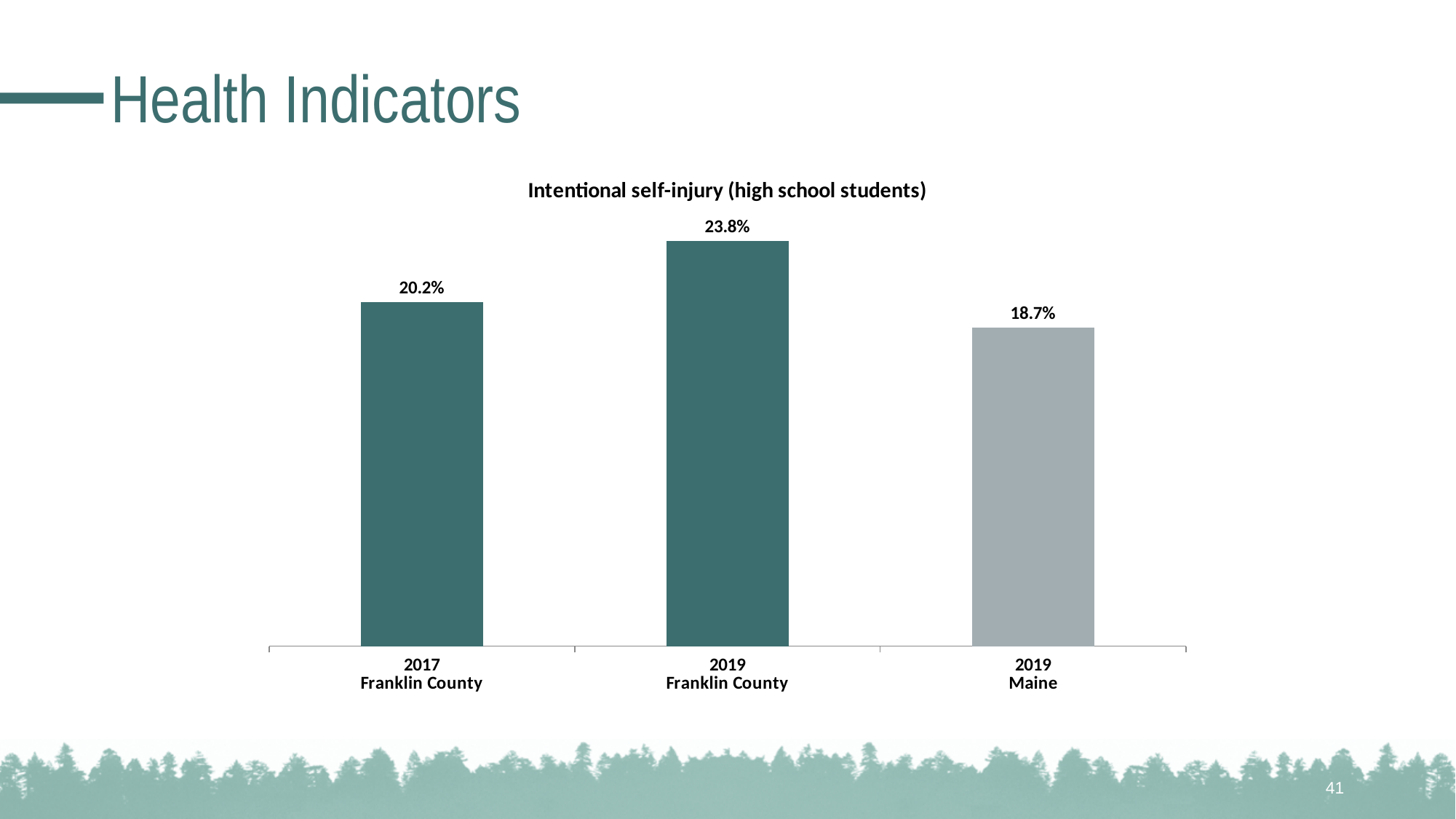
Did the Franklin County value rise or fall from 2017 to 2019? Rise What is the difference between the 2019 Franklin County value and the 2019 Maine value? 5.1% Which is larger, the value for 2019 Franklin County or the value for 2019 Maine? 2019 Franklin County What is the difference between the 2019 Franklin County value and the 2017 Franklin County value? 3.6% What is the value for 2019 Franklin County? 23.8% What is the title of the chart? Intentional self-injury (high school students) What kind of chart is shown on the slide? Bar chart What is the value for 2017 Franklin County? 20.2% How many bars are shown in the chart? 3 Which category has the lowest value? 2019 Maine Which category has the highest value? 2019 Franklin County What is the value for 2019 Maine? 18.7%